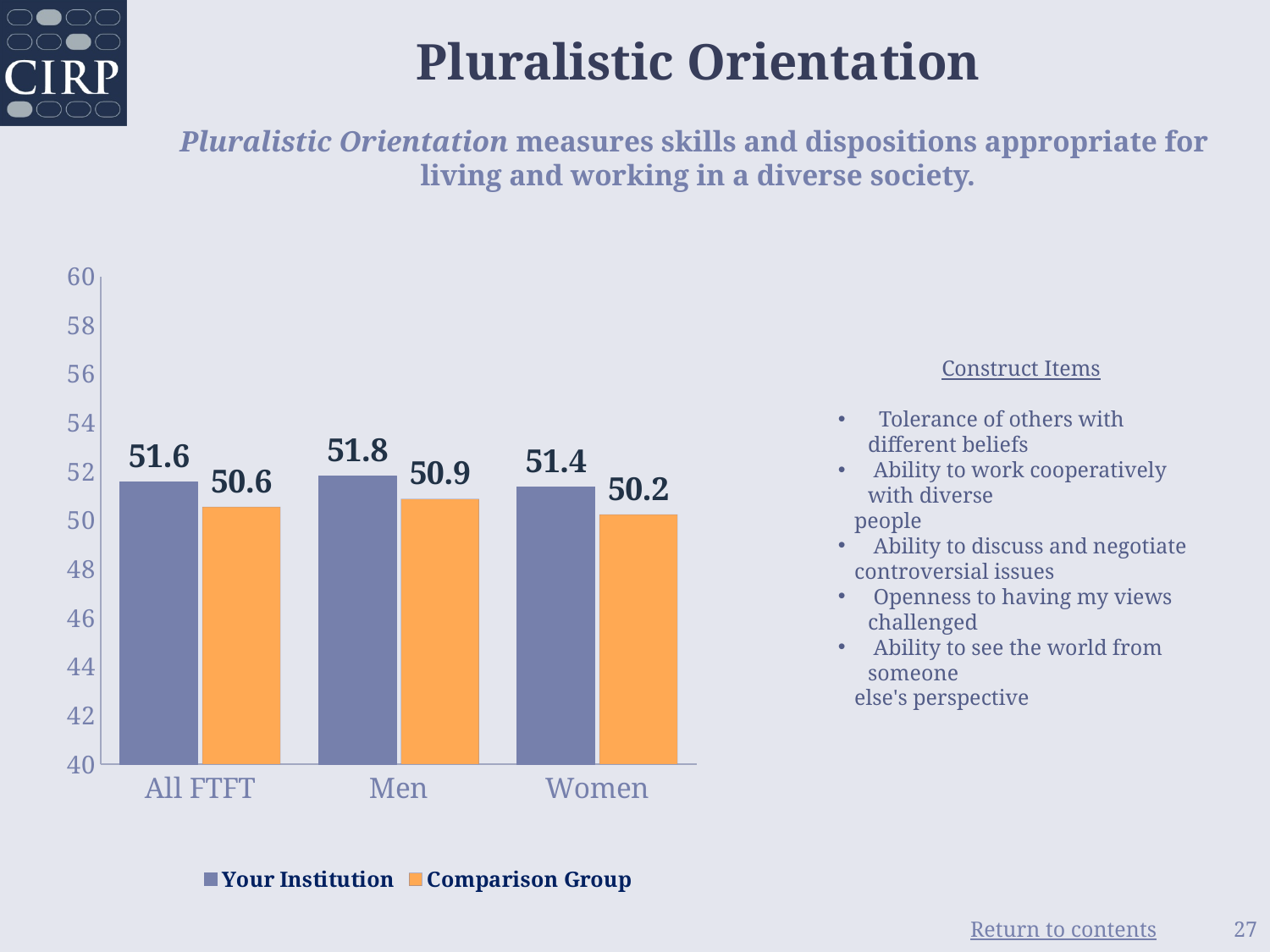
What is the difference between Your Institution and the Comparison Group for Women? 1.2 What is the value for the Comparison Group for Women? 50.2 What is the difference between Your Institution and the Comparison Group for All FTFT? 1.0 What kind of chart is shown on the slide? bar chart Is the value for the Comparison Group for Women greater or less than 52? less How many series does the legend list? 2 What is the value for Your Institution for All FTFT? 51.6 How many categories are shown on the x axis? 3 Which is larger for Men: Your Institution or the Comparison Group? Your Institution What is the value for Your Institution for Men? 51.8 Which category has the highest value for the Comparison Group? Men Which category has the lowest value for Your Institution? Women